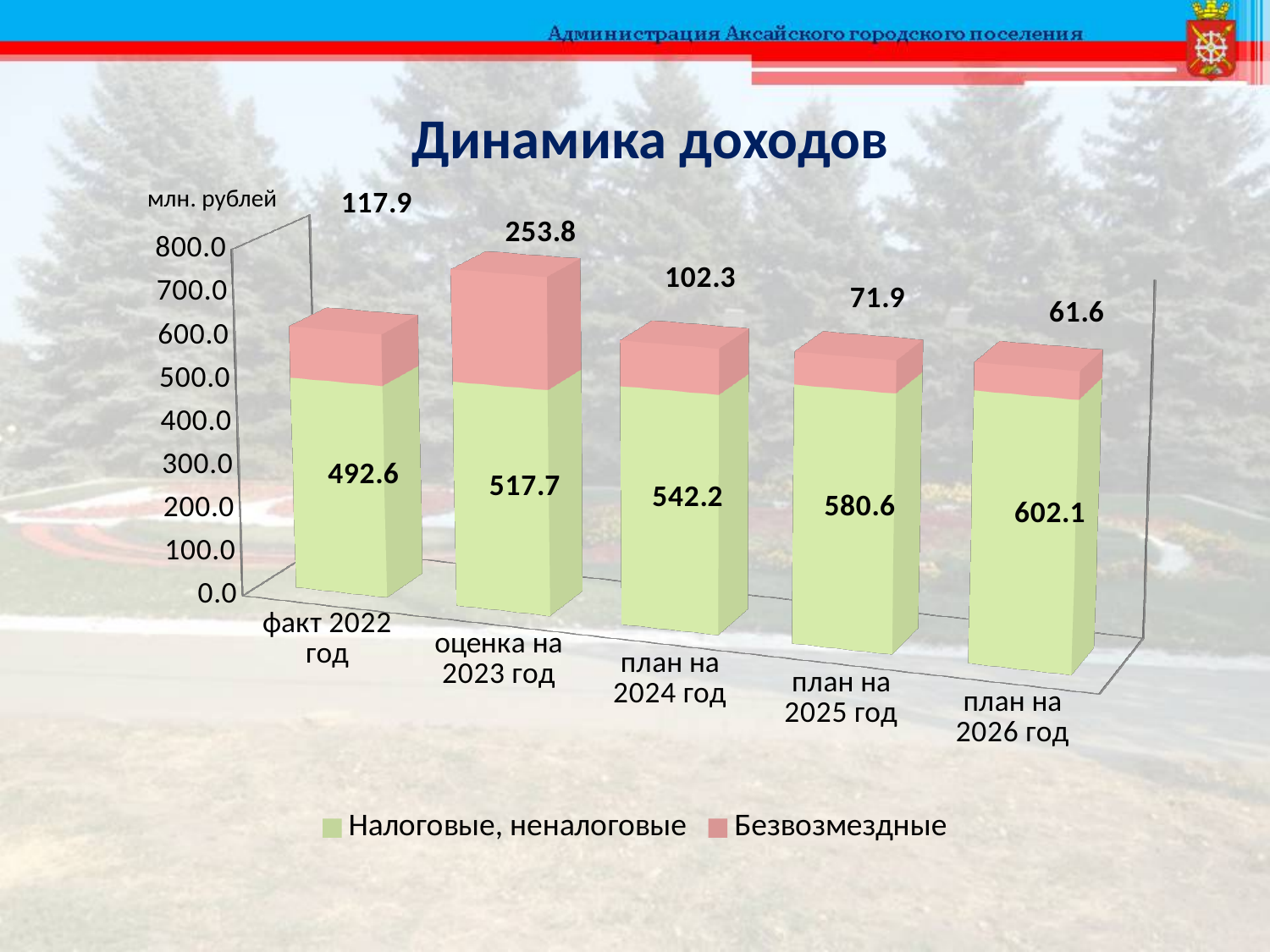
What is the difference between the 'Налоговые, неналоговые' values for 'план на 2026 год' and 'факт 2022 год'? 109.5 Which is larger: the 'Безвозмездные' value for 'факт 2022 год' or for 'план на 2024 год'? факт 2022 год Which category has the highest value for the 'Налоговые, неналоговые' series? план на 2026 год What is the value of the 'Налоговые, неналоговые' series for 'факт 2022 год'? 492.6 What is the total of the stacked bar for 'план на 2025 год'? 652.5 What is the value of the 'Безвозмездные' series for 'план на 2026 год'? 61.6 What is the total of the stacked bar for 'оценка на 2023 год'? 771.5 What is the value of the 'Безвозмездные' series for 'оценка на 2023 год'? 253.8 What kind of chart is shown on the slide? Stacked bar chart Which category has the lowest value for the 'Безвозмездные' series? план на 2026 год How many categories are shown on the x axis? 5 How many series does the legend list? 2